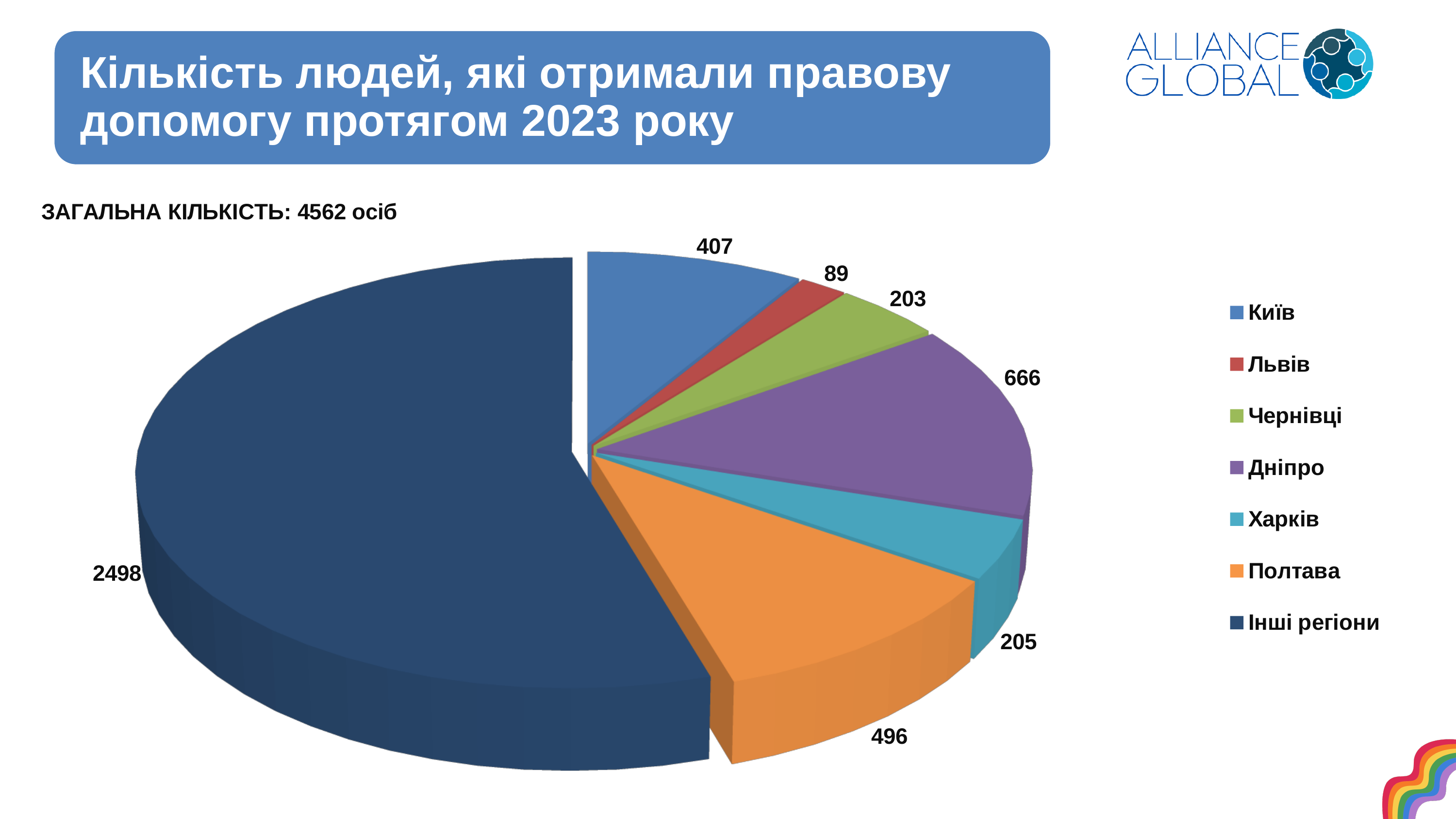
Which category has the largest slice of the pie? Інші регіони How many people received legal aid in Київ according to the chart? 407 What is the value shown for Інші регіони? 2498 Which category has the smallest slice of the pie? Львів What kind of chart is shown on the slide? pie chart What is the difference between the values for Київ and Львів? 318 How many categories does the pie chart have? 7 What is the difference between the values for Дніпро and Полтава? 170 Which is larger, the value for Харків or the value for Київ? Київ What colour is the slice for Полтава in the legend? orange What is the value shown for Дніпро? 666 What is the value shown for Полтава? 496